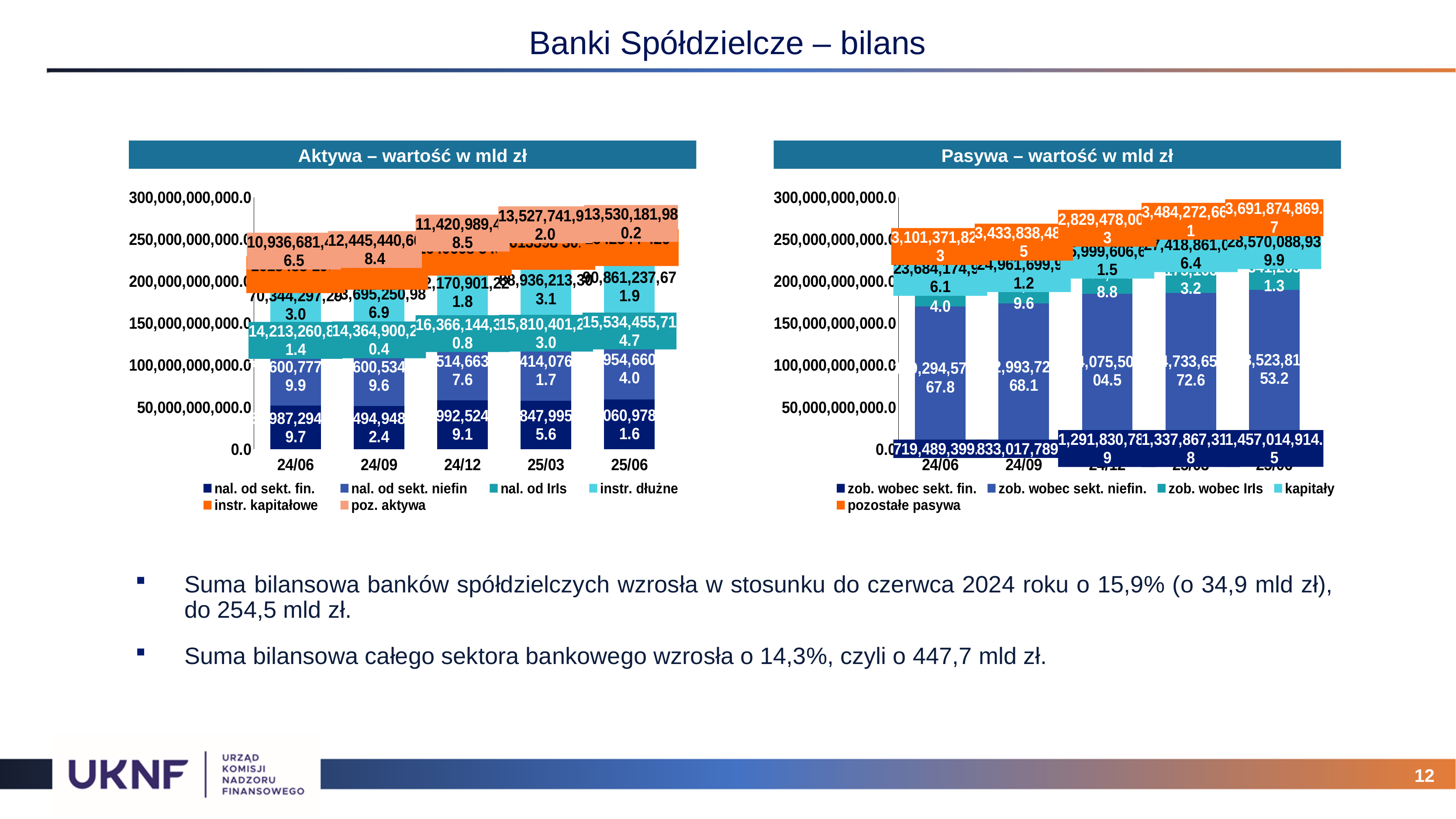
In the 'Pasywa – wartość w mld zł' chart, is the top of the 'zob. wobec sekt. niefin.' segment for 25/06 greater or less than 150,000,000,000.0? greater Which series is listed last in the legend of the 'Pasywa – wartość w mld zł' chart? pozostałe pasywa What kind of chart is the 'Pasywa – wartość w mld zł' chart? Stacked bar chart In the 'Pasywa – wartość w mld zł' chart, does the height of the 'zob. wobec sekt. niefin.' segment rise or fall from 24/06 to 25/06? rise Which period is the first on the x axis of the 'Aktywa – wartość w mld zł' chart? 24/06 In the 'Pasywa – wartość w mld zł' chart, is the top of the 'zob. wobec sekt. niefin.' segment for 24/06 greater or less than 100,000,000,000.0? greater How many series does the legend of the 'Pasywa – wartość w mld zł' chart list? 5 How many series does the legend of the 'Aktywa – wartość w mld zł' chart list? 6 How many periods are shown on the x axis of the 'Aktywa – wartość w mld zł' chart? 5 How many periods are shown on the x axis of the 'Pasywa – wartość w mld zł' chart? 5 What kind of chart is the 'Aktywa – wartość w mld zł' chart? Stacked bar chart